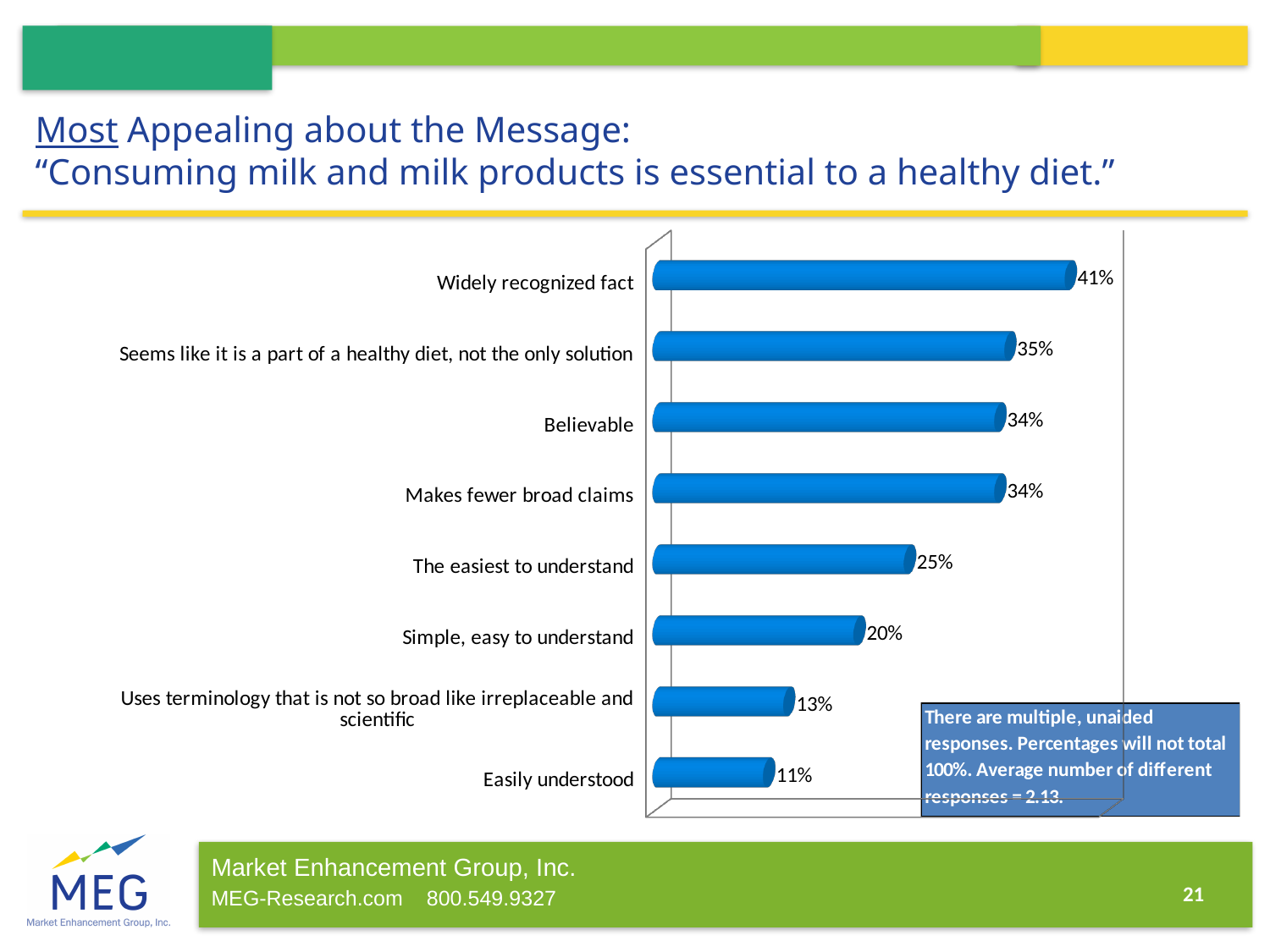
What percentage is shown for "Believable"? 34% What is the difference between the percentages for "The easiest to understand" and "Easily understood"? 14% What percentage is shown for "Easily understood"? 11% Which category has the lowest percentage? Easily understood What is the difference between the percentages for "Widely recognized fact" and "Seems like it is a part of a healthy diet, not the only solution"? 6% How many categories are shown in the chart? 8 What kind of chart is shown on the slide? Bar chart Which has a higher percentage, "The easiest to understand" or "Simple, easy to understand"? The easiest to understand What percentage is shown for "Widely recognized fact"? 41% According to the note on the chart, what is the average number of different responses? 2.13 What percentage is shown for "Simple, easy to understand"? 20% Which category has the highest percentage? Widely recognized fact